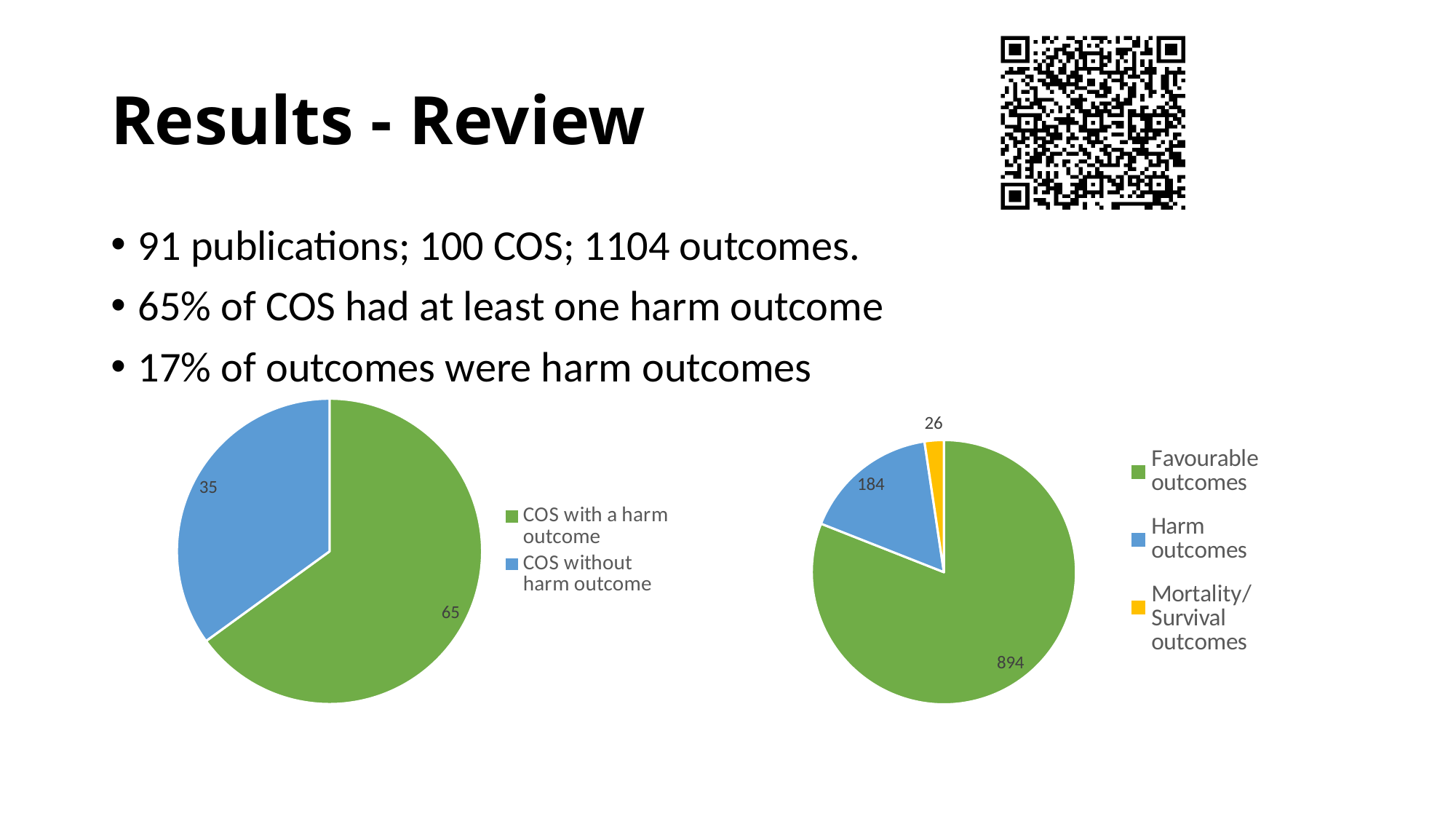
How many categories does the right pie chart show? 3 In the right pie chart, which is larger: Harm outcomes or Mortality/Survival outcomes? Harm outcomes In the right pie chart, which category has the smallest slice? Mortality/Survival outcomes In the left pie chart, what is the difference between COS with a harm outcome and COS without harm outcome? 30 In the left pie chart, what is the value for COS with a harm outcome? 65 In the right pie chart, what is the difference between Favourable outcomes and Harm outcomes? 710 In the left pie chart, what is the value for COS without harm outcome? 35 In the right pie chart, what is the value for Harm outcomes? 184 In the right pie chart, which category has the largest slice? Favourable outcomes What type of chart is the left chart on the slide? Pie chart In the left pie chart, what share of the total does COS without harm outcome represent? 35% In the right pie chart, what is the value for Mortality/Survival outcomes? 26